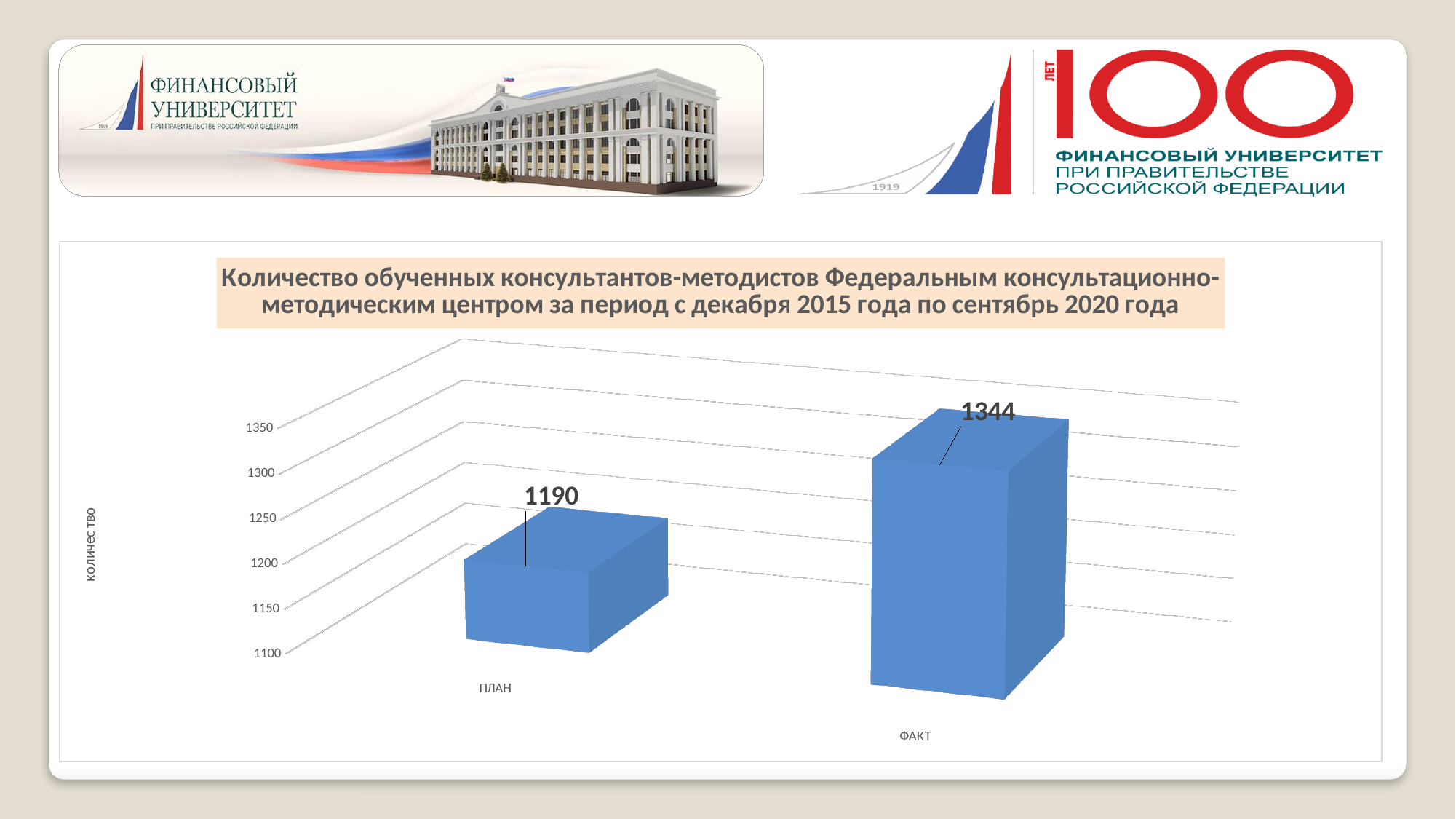
Which category has the lowest value? ПЛАН Is the value for ФАКТ greater or less than 1300? greater Is the value for ПЛАН greater or less than 1200? less What is the value for ФАКТ? 1344 What is the label of the vertical axis? КОЛИЧЕСТВО What is the value for ПЛАН? 1190 What is the difference between the values for ФАКТ and ПЛАН? 154 What is the lowest tick value shown on the vertical axis? 1100 Which category has the highest value? ФАКТ What kind of chart is shown on the slide? bar chart How many categories are shown on the chart? 2 Which is larger, the value for ПЛАН or the value for ФАКТ? ФАКТ